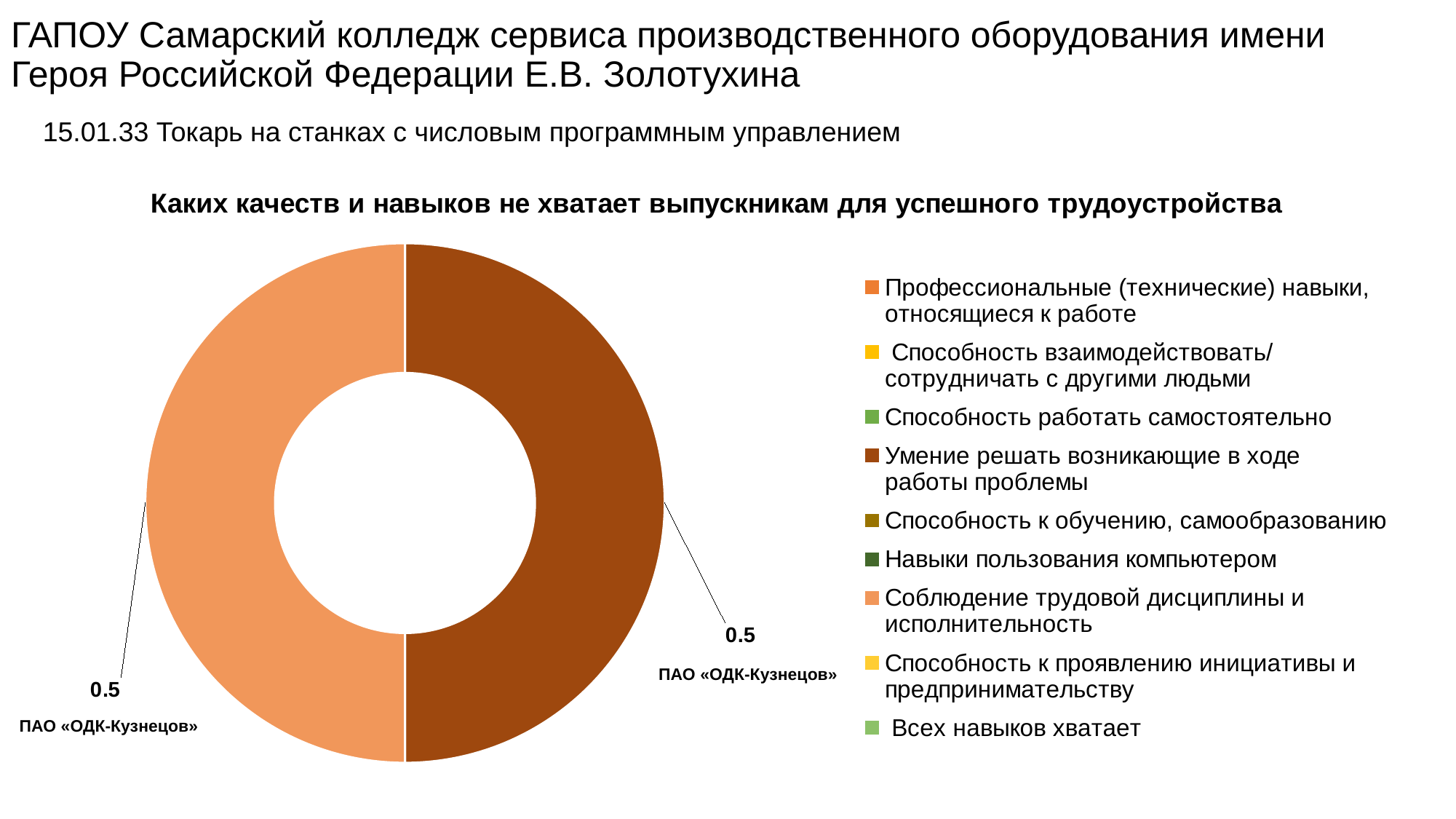
Which legend category does the dark brown slice correspond to? Умение решать возникающие в ходе работы проблемы What share of the doughnut does the dark brown slice take up? 0.5 What value is printed on the dark brown slice of the doughnut? 0.5 What type of chart is shown on the slide? doughnut (pie) chart What organisation name is printed next to both data labels? ПАО «ОДК-Кузнецов» What is the difference between the values of the two slices? 0 What value is printed on the light orange slice on the left of the doughnut? 0.5 What is the total of the two slice values shown? 1 What is the title of the chart? Каких качеств и навыков не хватает выпускникам для успешного трудоустройства Are the two slices of the doughnut equal in size? yes How many slices are visible in the doughnut chart? 2 How many entries does the chart legend list? 9